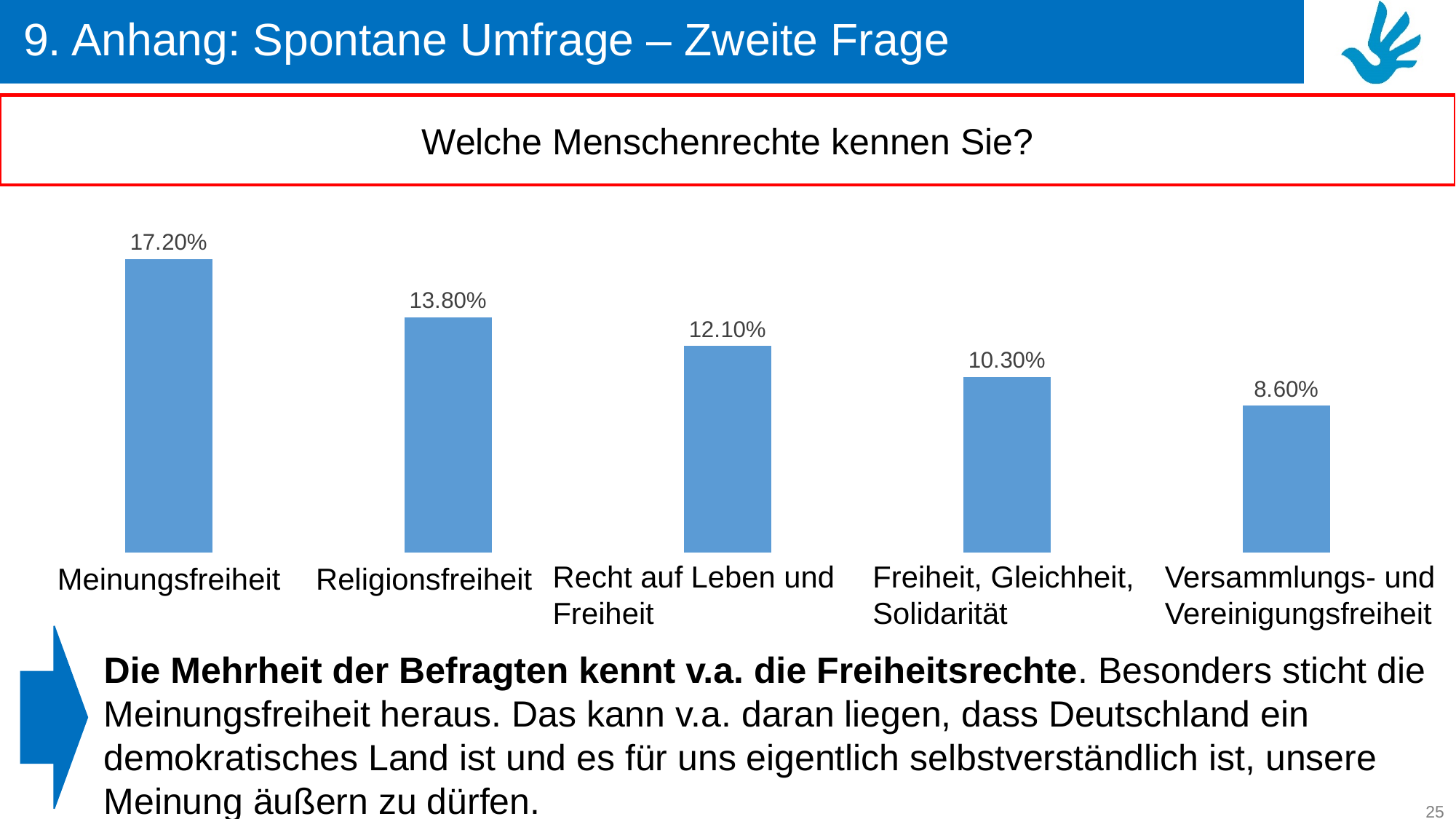
What kind of chart is shown on the slide? Bar chart Which is larger, the value for Recht auf Leben und Freiheit or the value for Freiheit, Gleichheit, Solidarität? Recht auf Leben und Freiheit Do the values rise or fall from left to right along the x axis? Fall How many categories are shown in the chart? 5 What is the value for Religionsfreiheit? 13.80% Which category has the lowest value? Versammlungs- und Vereinigungsfreiheit What is the value for Freiheit, Gleichheit, Solidarität? 10.30% What is the difference between the values for Meinungsfreiheit and Religionsfreiheit? 3.40% What is the value for Meinungsfreiheit? 17.20% What is the value for Recht auf Leben und Freiheit? 12.10% Which category has the highest value? Meinungsfreiheit What is the value for Versammlungs- und Vereinigungsfreiheit? 8.60%